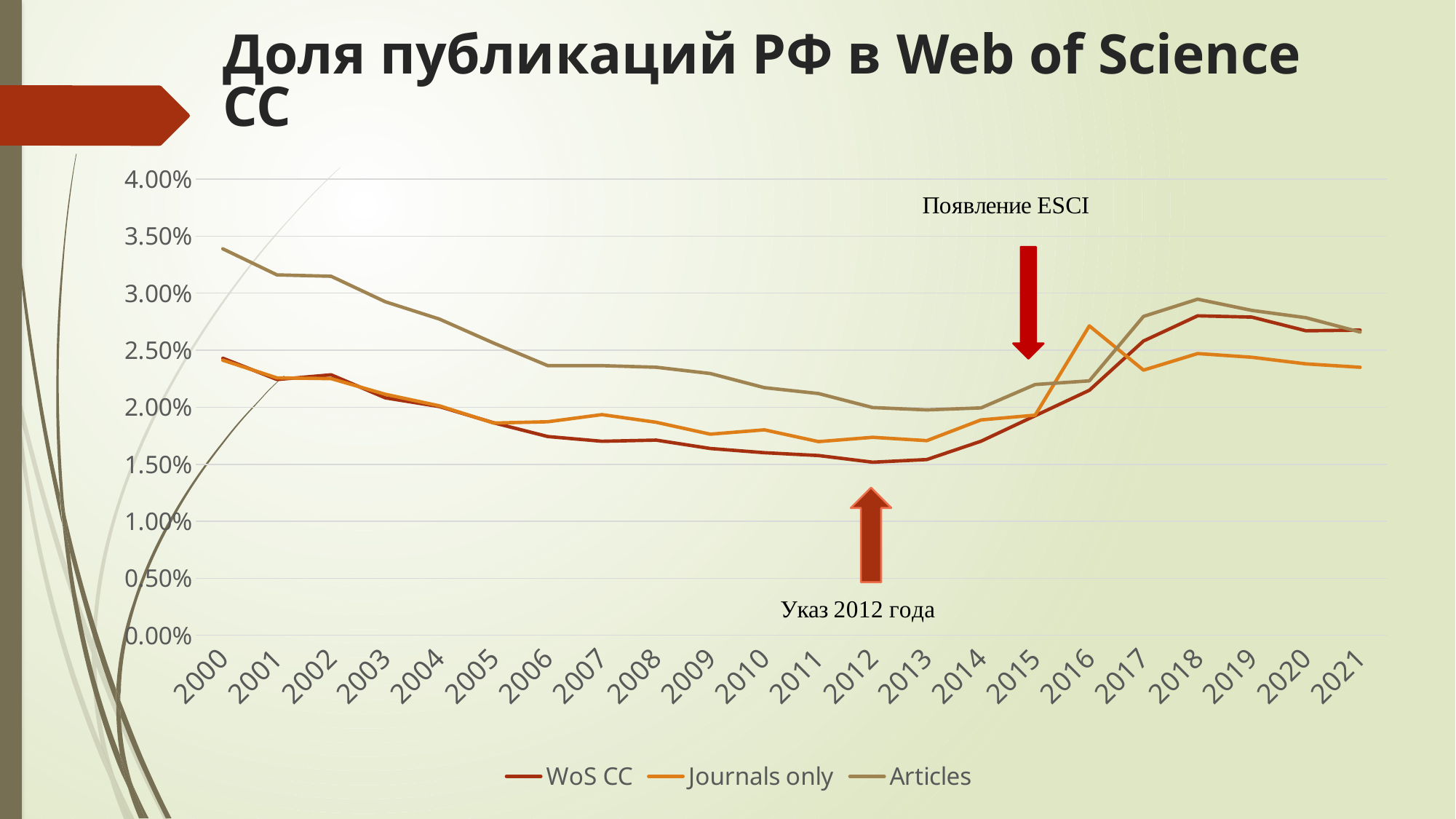
In which year does the Articles series reach its highest value? 2000 How many years are plotted along the x axis? 22 Is the value for Journals only in 2016 greater or less than 2.50%? greater What is the title of the chart on the slide? Доля публикаций РФ в Web of Science CC Does the Articles series rise or fall from 2000 to 2012? Fall Is the value for Articles in 2000 greater or less than 3.00%? greater How many series does the legend list? 3 Does the WoS CC series rise or fall from 2012 to 2018? Rise Is the value for WoS CC in 2000 greater or less than 2.50%? less Which series has the highest value in 2016? Journals only What kind of chart is shown on the slide? Line chart Which series are listed in the legend? WoS CC, Journals only, Articles